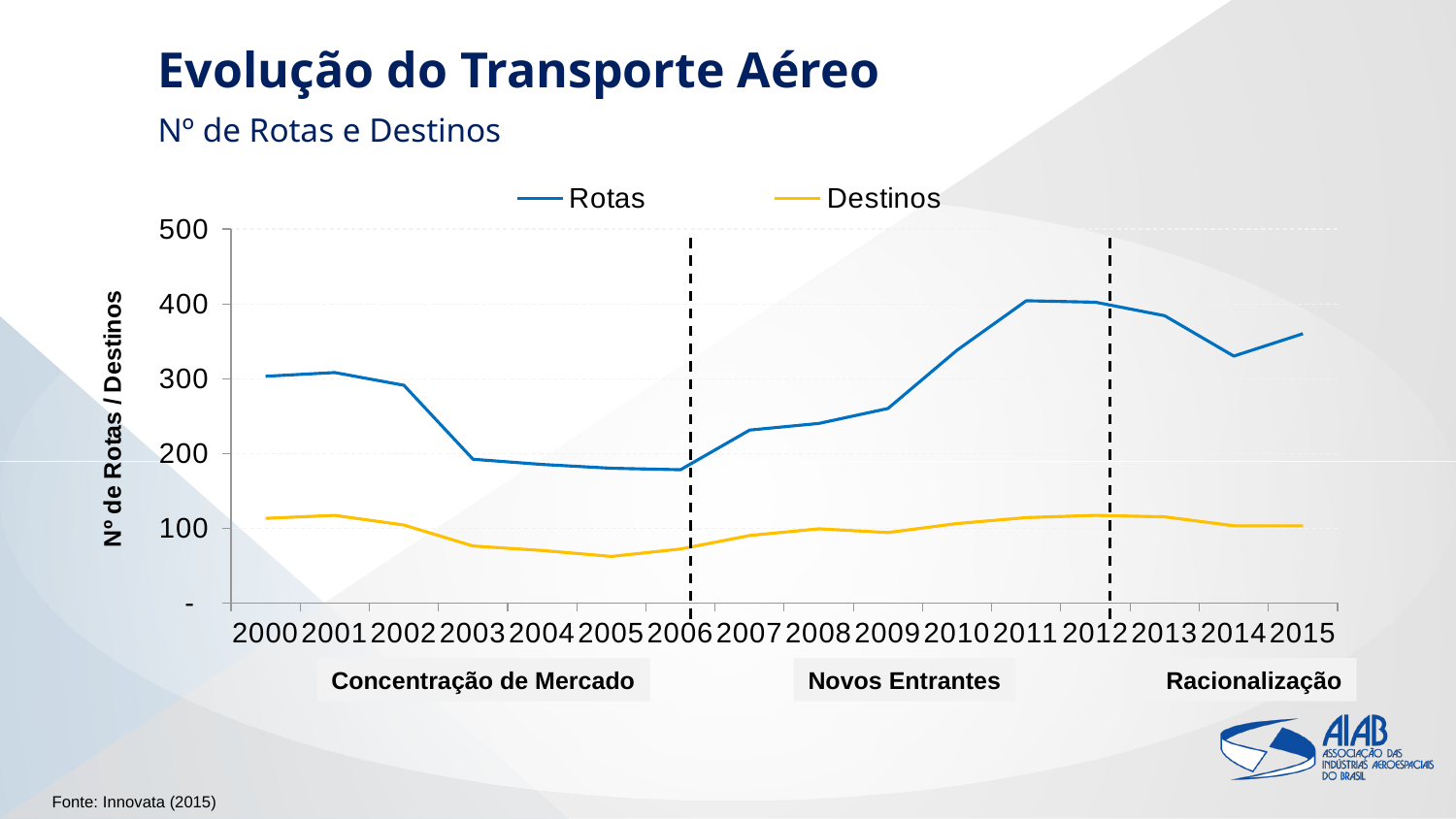
What are the three phase labels shown below the x axis? Concentração de Mercado, Novos Entrantes, Racionalização What kind of chart is shown on the slide? Line chart How many series does the legend list? 2 Is the value for Rotas in 2003 greater or less than 200? less Does the Rotas series rise or fall from 2006 to 2011? rise Is the value for Rotas in 2014 greater or less than 300? greater How many years are plotted along the x axis? 16 Which is larger, the Destinos value in 2000 or the Destinos value in 2005? 2000 In which year is the Destinos series at its lowest? 2005 Is the value for Destinos in 2005 greater or less than 100? less Which is larger, the Rotas value in 2011 or the Rotas value in 2006? 2011